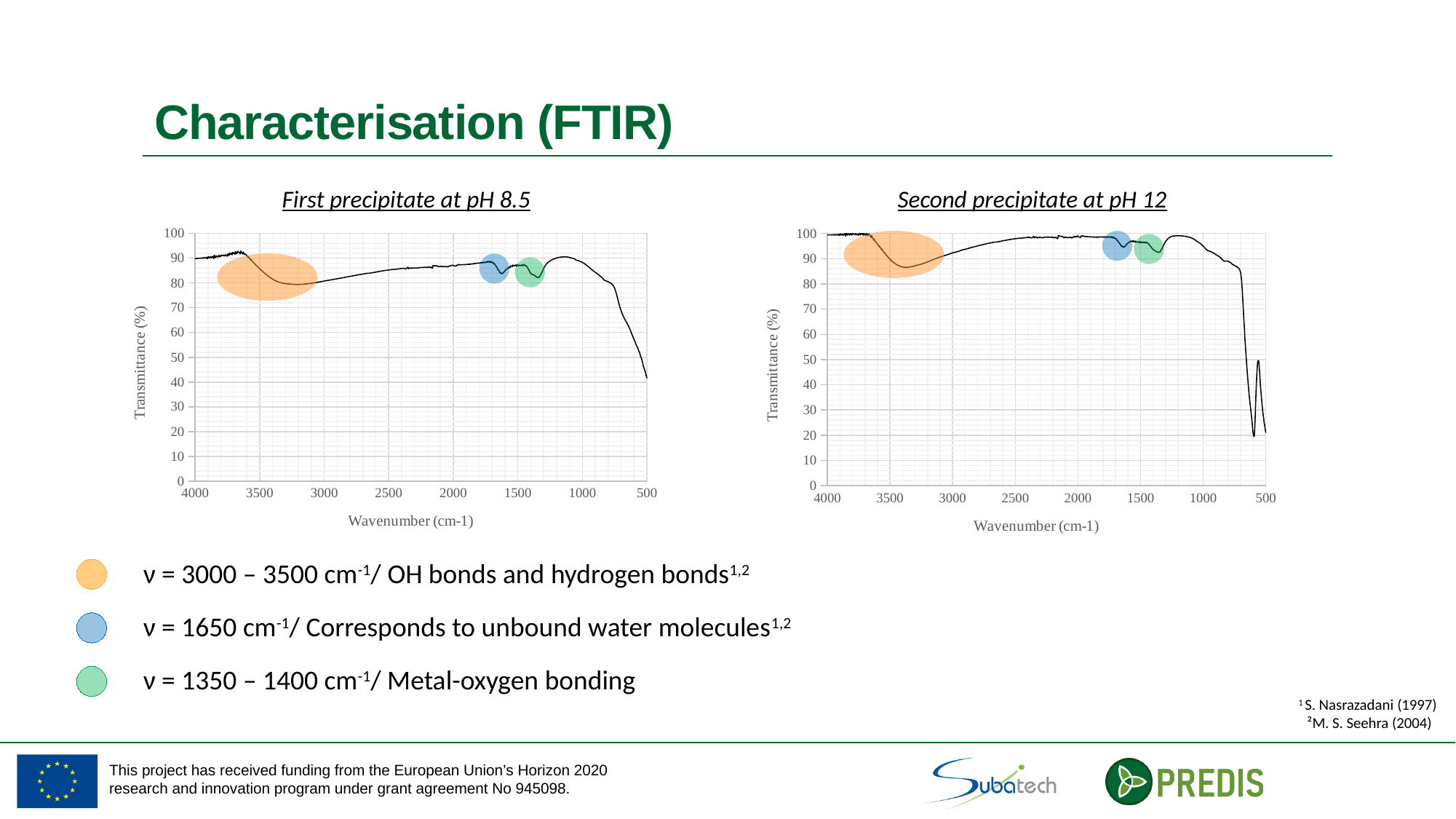
In the 'Second precipitate at pH 12' chart, is the transmittance at 4000 cm-1 greater or less than 90? greater In the 'First precipitate at pH 8.5' chart, does the transmittance rise or fall as the wavenumber decreases from 1000 to 500 cm-1? fall In the 'First precipitate at pH 8.5' chart, is the transmittance at 500 cm-1 greater or less than 50? less How many charts are shown on the slide? 2 What is the title of the chart on the right side of the slide? Second precipitate at pH 12 At 4000 cm-1, which chart shows the higher transmittance, 'First precipitate at pH 8.5' or 'Second precipitate at pH 12'? Second precipitate at pH 12 In the 'First precipitate at pH 8.5' chart, is the transmittance at 4000 cm-1 greater or less than 80? greater What is the y-axis label of the 'Second precipitate at pH 12' chart? Transmittance (%) In the 'Second precipitate at pH 12' chart, does the transmittance rise or fall as the wavenumber decreases from 3500 to 3000 cm-1? rise What kind of chart is the 'First precipitate at pH 8.5' chart? Line chart